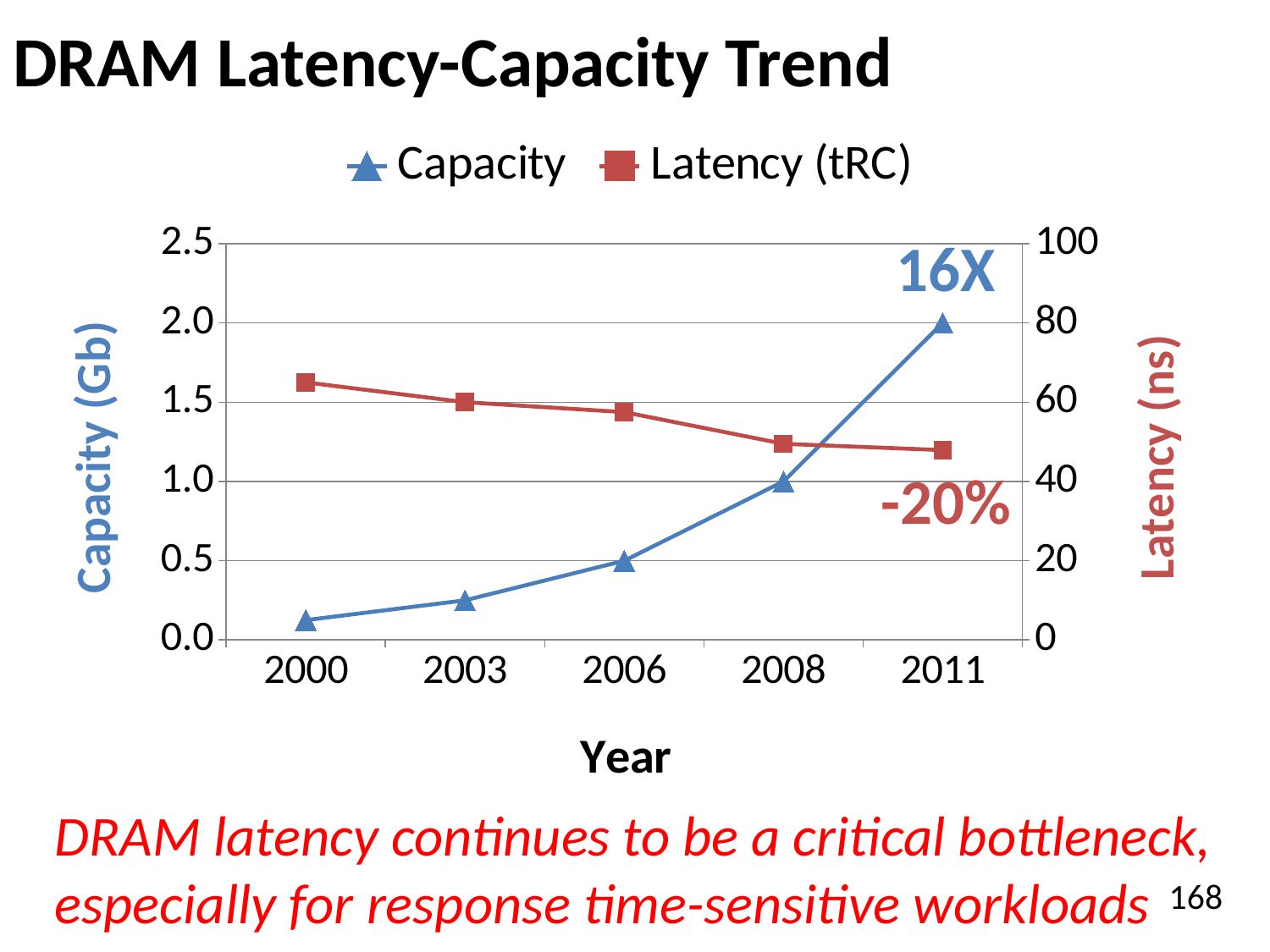
Is the latency (tRC) value for 2000 greater or less than 60? greater What kind of chart is shown on the slide? line chart Which year has the lowest latency (tRC)? 2011 What annotation is printed next to the capacity line at 2011? 16X Which year has the highest capacity? 2011 What is the capacity value for 2011? 2.0 What is the latency (tRC) value for 2003? 60 What is the capacity value for 2008? 1.0 How many series does the legend list? 2 Does the latency (tRC) series rise or fall from 2000 to 2011? fall Is the capacity value for 2006 greater or less than 1.0? less How many years are plotted along the x axis? 5